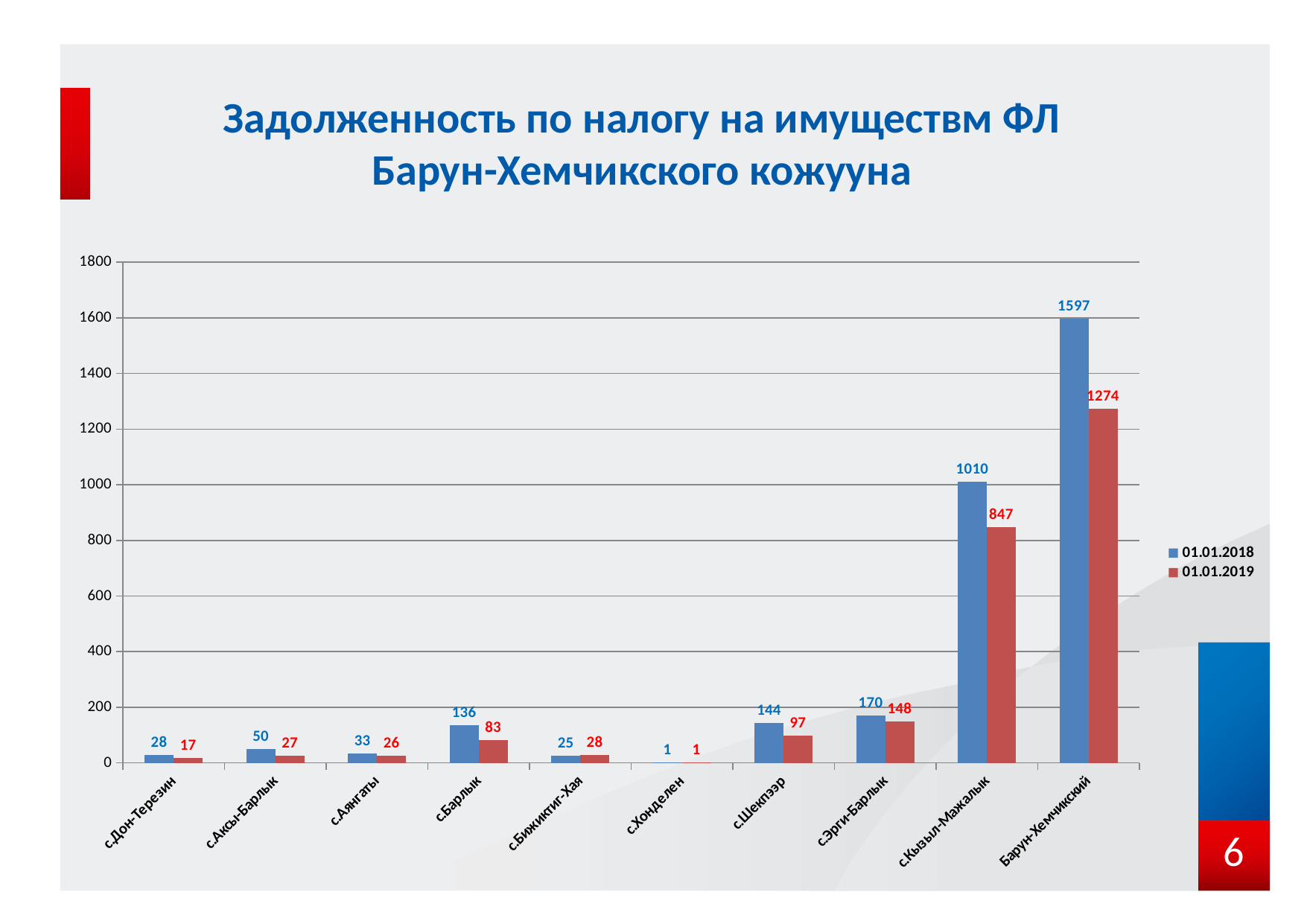
What is the difference between the 01.01.2018 and 01.01.2019 values for с.Кызыл-Мажалык? 163 Which category has the lowest value in the 01.01.2019 series? с.Хонделен What is the value for с.Барлык in the 01.01.2019 series? 83 What is the difference between the 01.01.2018 and 01.01.2019 values for Барун-Хемчикский? 323 What kind of chart is shown on the slide? bar chart What is the value for Барун-Хемчикский in the 01.01.2018 series? 1597 How many series does the legend list? 2 Which is larger for с.Бижиктиг-Хая: the 01.01.2018 value or the 01.01.2019 value? 01.01.2019 What is the value for с.Кызыл-Мажалык in the 01.01.2019 series? 847 Is the 01.01.2019 value for с.Кызыл-Мажалык greater or less than 1000? less How many categories are shown on the x axis? 10 Which category has the highest value in the 01.01.2018 series? Барун-Хемчикский